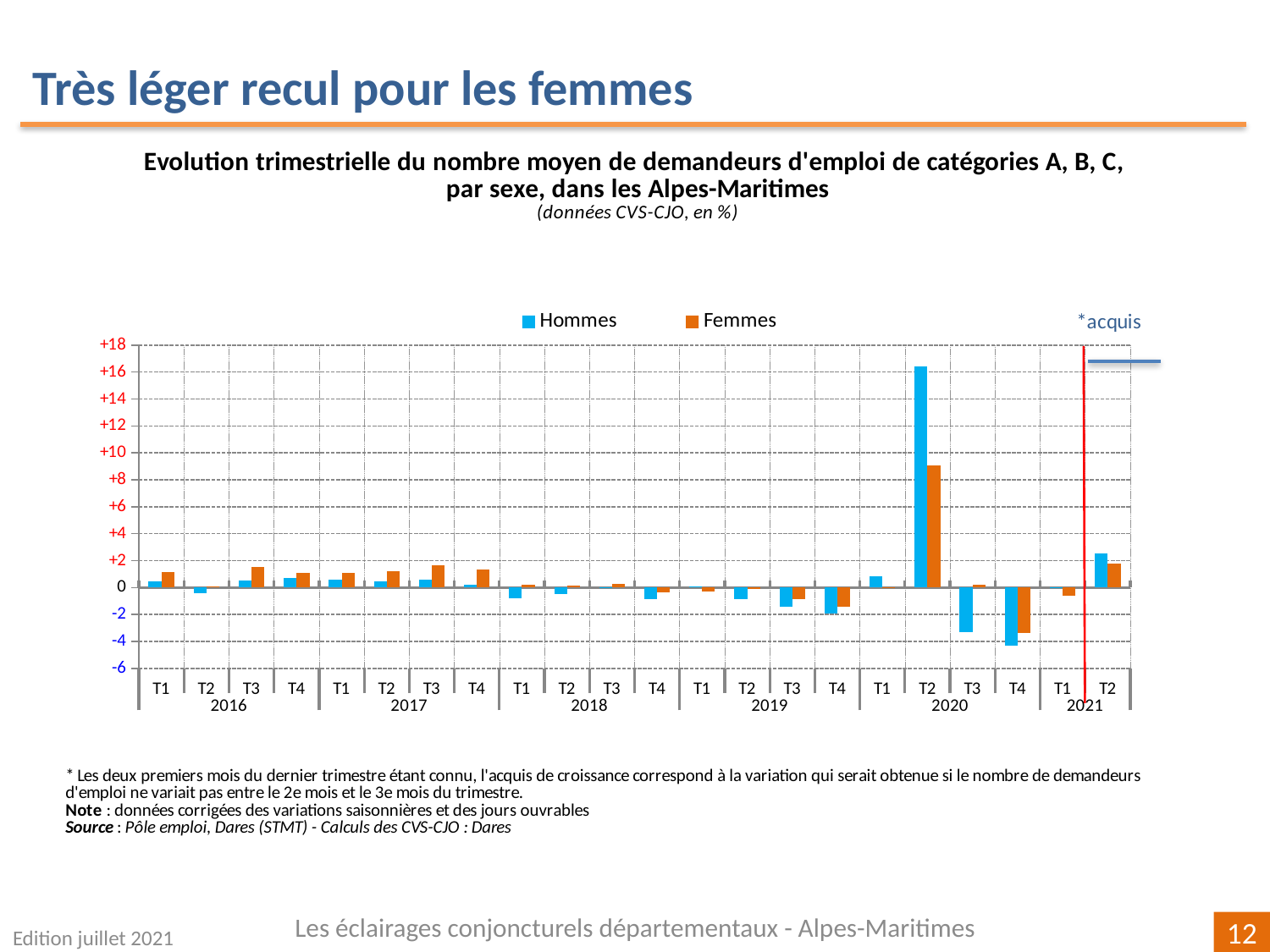
Is the Hommes value for T2 2020 greater or less than +14? greater How many quarters are plotted along the x axis? 22 In which quarter is the Femmes value lowest? T4 2020 Which colour represents the Femmes series in the legend? Orange In T2 2020, which series has the larger value, Hommes or Femmes? Hommes What kind of chart is shown on the slide? Bar chart Is the Femmes value for T2 2020 greater or less than +8? greater How many series does the legend list? 2 In which quarter is the Femmes value highest? T2 2020 In which quarter is the Hommes value highest? T2 2020 In which quarter is the Hommes value lowest? T4 2020 Is the Hommes value for T3 2020 greater or less than -2? less